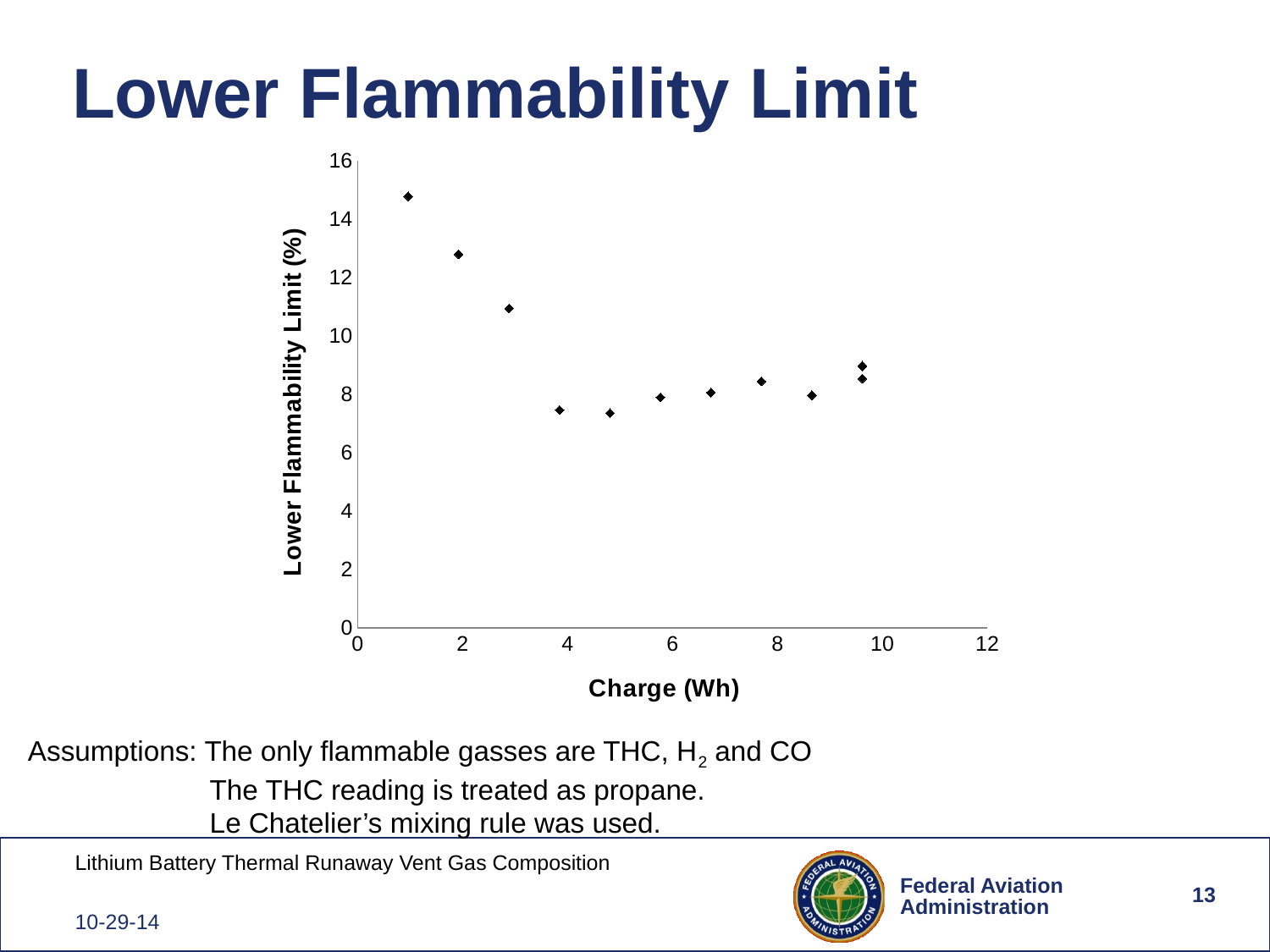
Is the lower flammability limit at a charge of about 1 Wh greater or less than 14? greater What is the highest value shown on the y axis? 16 Which has the higher lower flammability limit: the point at about 1 Wh or the point at about 8 Wh? the point at about 1 Wh Is the lowest plotted lower flammability limit greater or less than 8? less What kind of chart is shown on the slide? scatter chart Does the lower flammability limit rise or fall as charge increases from about 1 Wh to about 4 Wh? fall Are all the points plotted at charges between 4 Wh and 10 Wh greater or less than 10%? less What is the label of the x axis? Charge (Wh) What is the label of the y axis? Lower Flammability Limit (%)